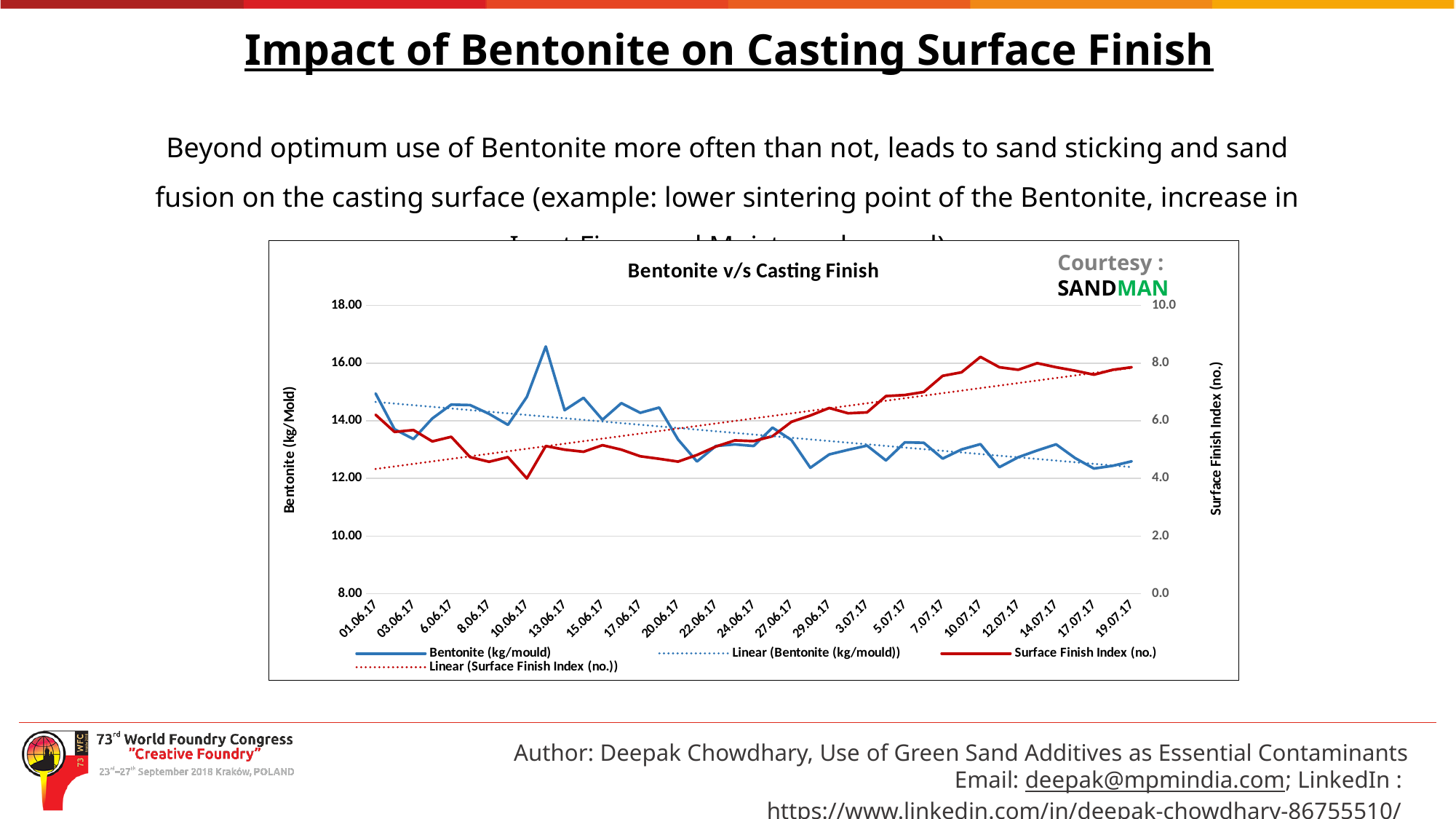
Is the Bentonite (kg/mould) value at 19.07.17 greater or less than 14.00? less Is the Bentonite (kg/mould) value at 13.06.17 greater or less than 16.00? less Does the Bentonite (kg/mould) line generally rise or fall from 01.06.17 to 19.07.17? Fall Does the Surface Finish Index (no.) line generally rise or fall from 01.06.17 to 19.07.17? Rise How many entries does the chart legend list? 4 What is the title of the right-hand vertical axis? Surface Finish Index (no.) On which date does the Surface Finish Index (no.) line reach its highest value? 10.07.17 Is the Surface Finish Index (no.) value at 19.07.17 greater or less than 6.0? greater What is the title of the chart? Bentonite v/s Casting Finish What kind of chart is shown on the slide? Line chart On which date does the Surface Finish Index (no.) line reach its lowest value? 10.06.17